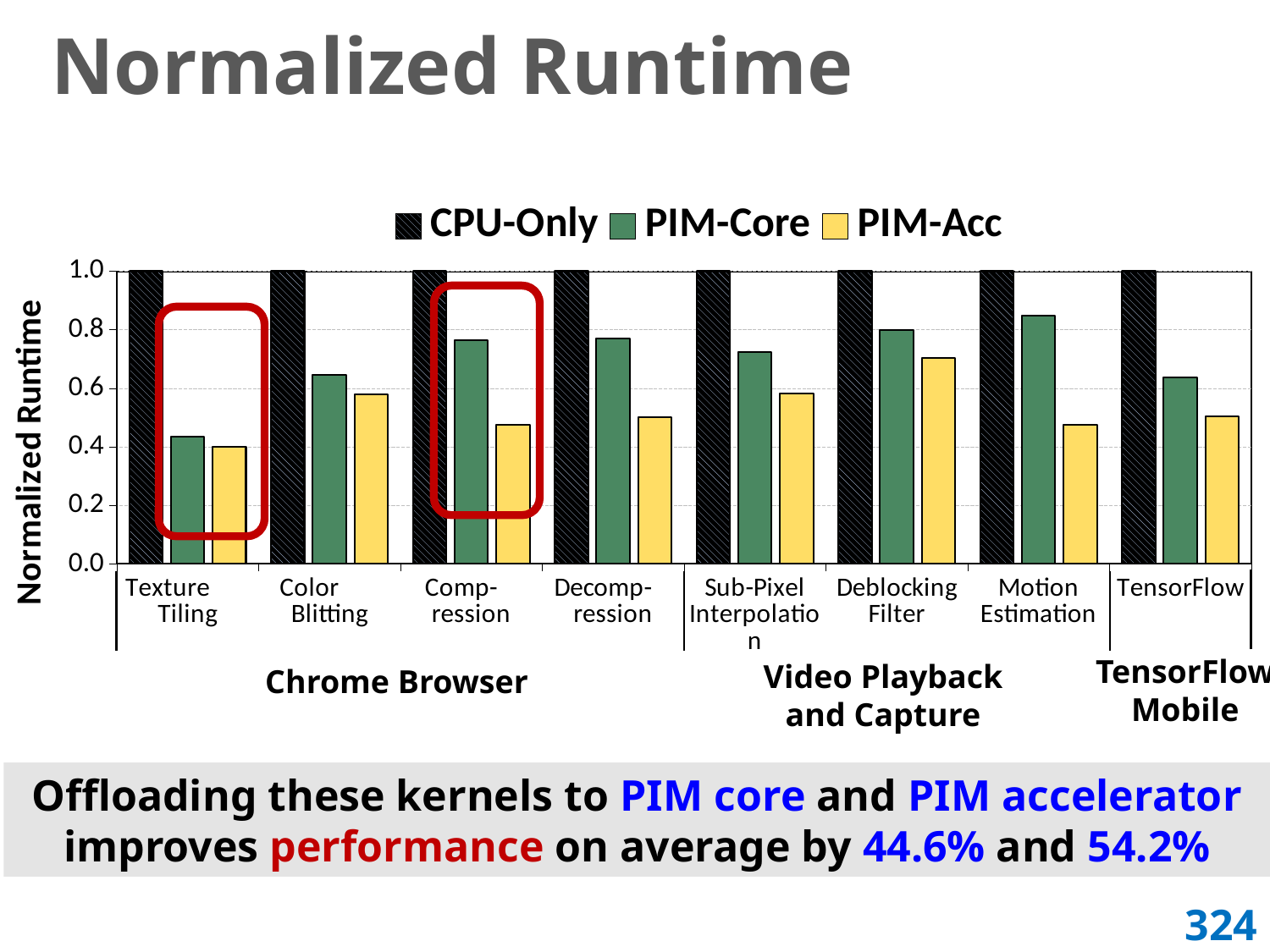
What is the CPU-Only normalized runtime for Texture Tiling? 1.0 Which three application groups are labeled beneath the x axis? Chrome Browser, Video Playback and Capture, TensorFlow Mobile How many kernels (categories) are plotted along the x axis? 8 For Compression, which is larger: the PIM-Core or the PIM-Acc normalized runtime? PIM-Core How many series does the legend list? 3 What kind of chart is shown on the slide? bar chart What is the CPU-Only normalized runtime for TensorFlow? 1.0 Which kernel has the highest PIM-Core normalized runtime? Motion Estimation Is the PIM-Core value for Compression greater or less than 0.6? greater Which kernel has the highest PIM-Acc normalized runtime? Deblocking Filter Which kernel has the lowest PIM-Core normalized runtime? Texture Tiling Is the PIM-Acc value for Texture Tiling greater or less than 0.6? less